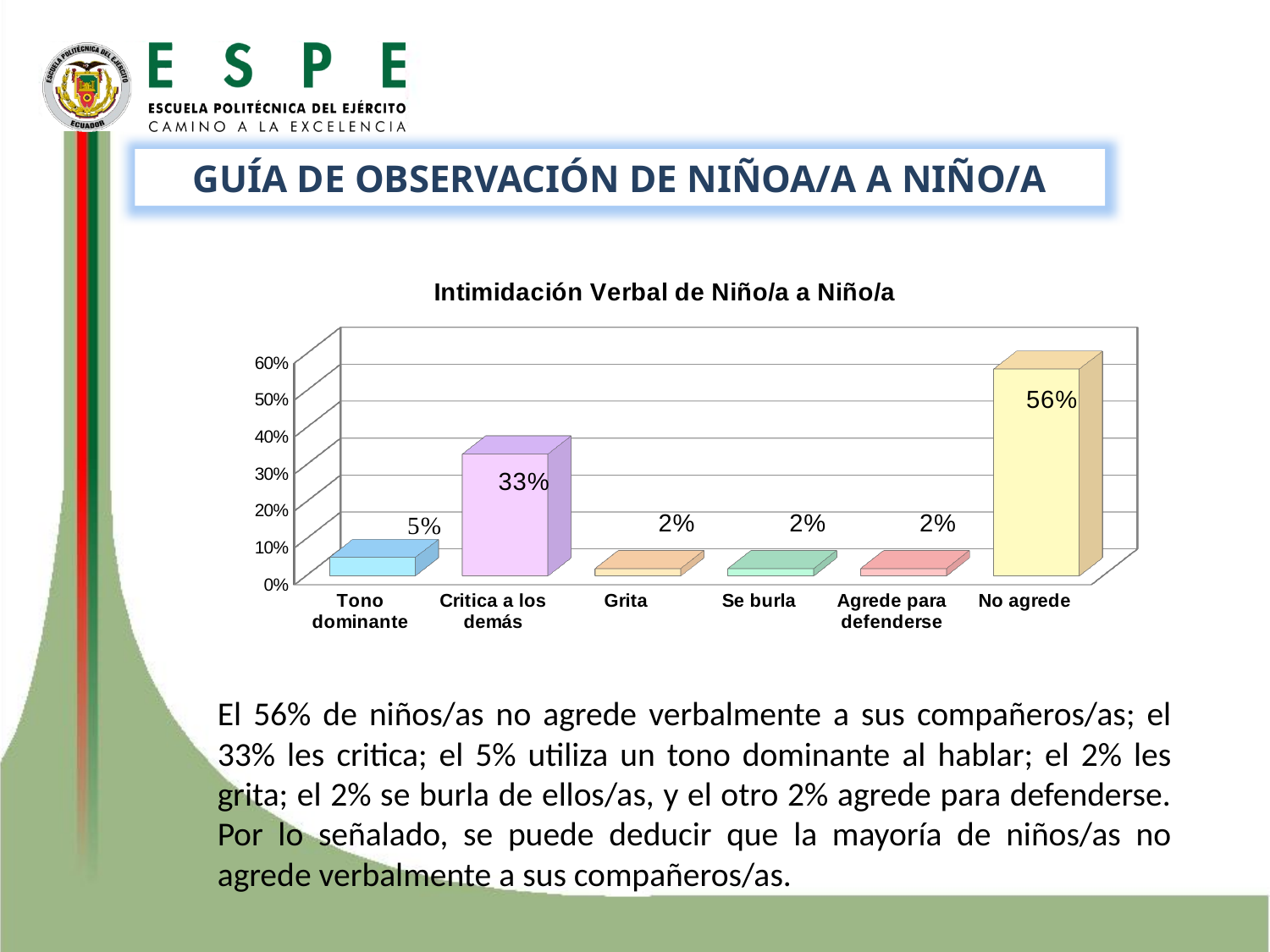
What is the difference between the values for "No agrede" and "Critica a los demás"? 23% What is the value for "Tono dominante"? 5% Which is larger, the value for "Critica a los demás" or the value for "Tono dominante"? Critica a los demás What is the title of the chart? Intimidación Verbal de Niño/a a Niño/a How many categories are shown on the x axis? 6 Which category has the highest value? No agrede Is the value for "No agrede" greater or less than 50%? greater What is the value for "Grita"? 2% What is the value for "Critica a los demás"? 33% What is the value for "No agrede"? 56% What is the difference between the values for "Tono dominante" and "Se burla"? 3% What kind of chart is shown? Bar chart